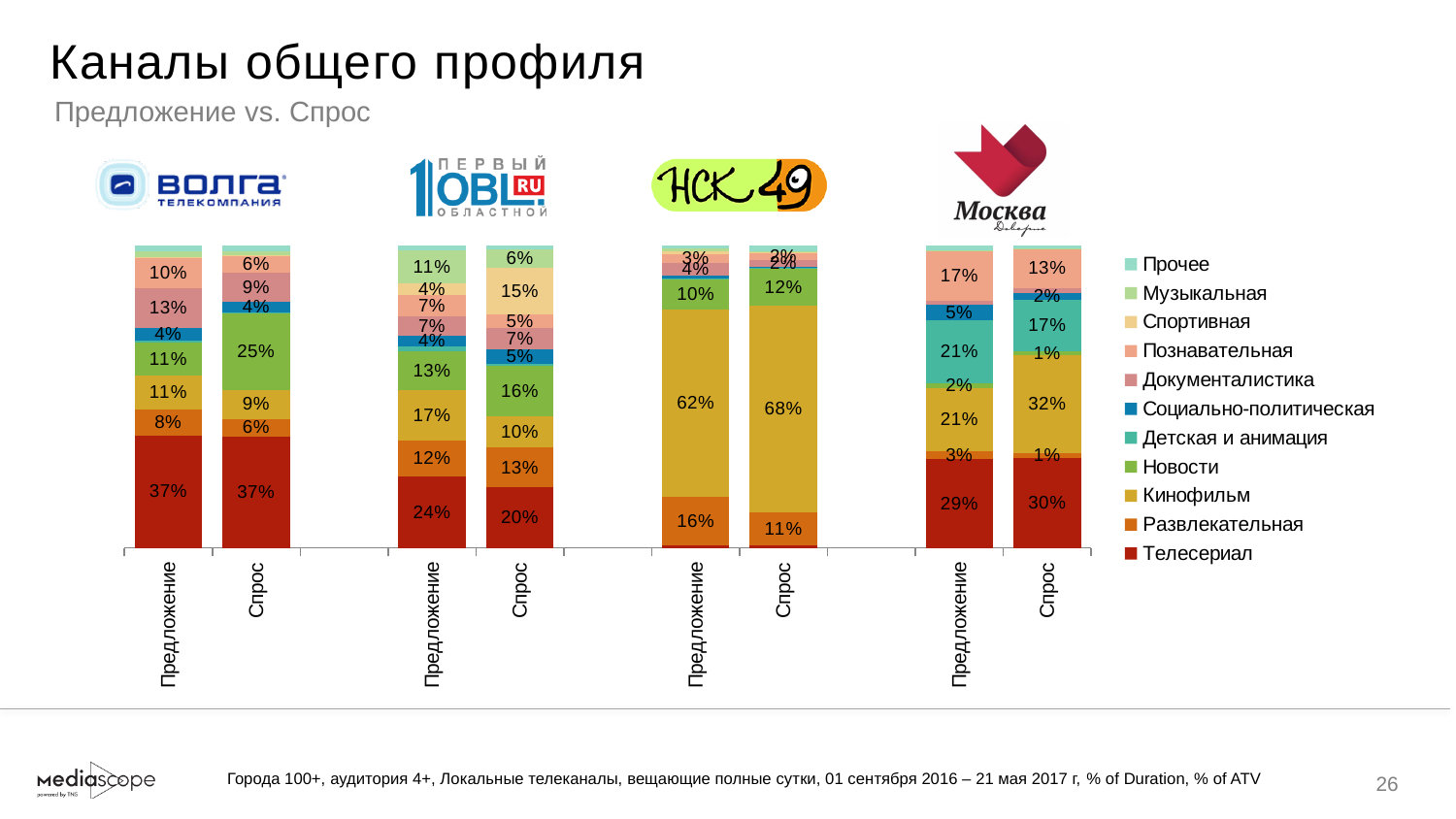
What kind of chart is used on this slide? Stacked bar chart On the Первый Областной chart, what is the value of Познавательная in the Спрос bar? 5% On the Волга chart, what is the value of Телесериал in the Предложение bar? 37% On the Волга chart, what is the value of Новости in the Спрос bar? 25% On the НСК 49 chart, what is the difference between the Кинофильм values in the Спрос and Предложение bars? 6% On the Волга chart, which segment is the largest in the Предложение bar? Телесериал On the НСК 49 chart, what is the value of Кинофильм in the Спрос bar? 68% On the Москва Доверие chart, what is the value of Кинофильм in the Спрос bar? 32% On the Москва Доверие chart, which is larger: Телесериал in Предложение or Телесериал in Спрос? Спрос How many series does the legend list? 11 How many bars does each chart on the slide have? 2 On the Первый Областной chart, what is the value of Телесериал in the Предложение bar? 24%